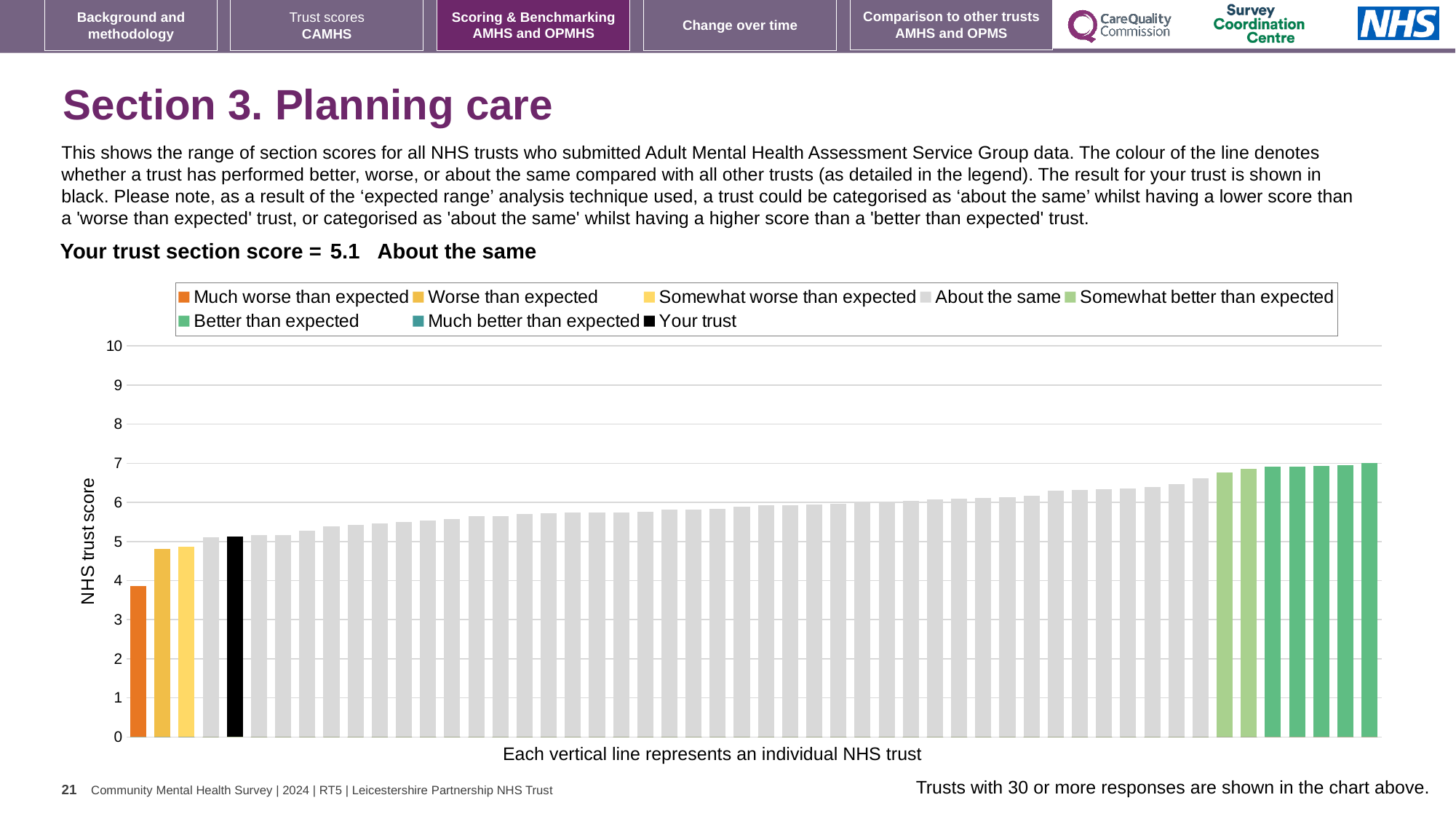
Which is higher: your trust's bar or the 'Much worse than expected' bar? your trust's bar How many categories does the chart legend list? 8 Is the value for the highest-scoring trust greater or less than 6? greater Is the value for the lowest-scoring trust (the orange bar) greater or less than 4? less How many bars are coloured as 'Much worse than expected'? 1 Do the trust scores rise or fall from left to right along the x axis? rise Is the value for your trust greater or less than 6? less What is your trust's section score for Planning care? 5.1 What kind of chart is shown on the slide? bar chart What is the label on the vertical axis of the chart? NHS trust score What colour is used for 'Your trust' in the chart? black